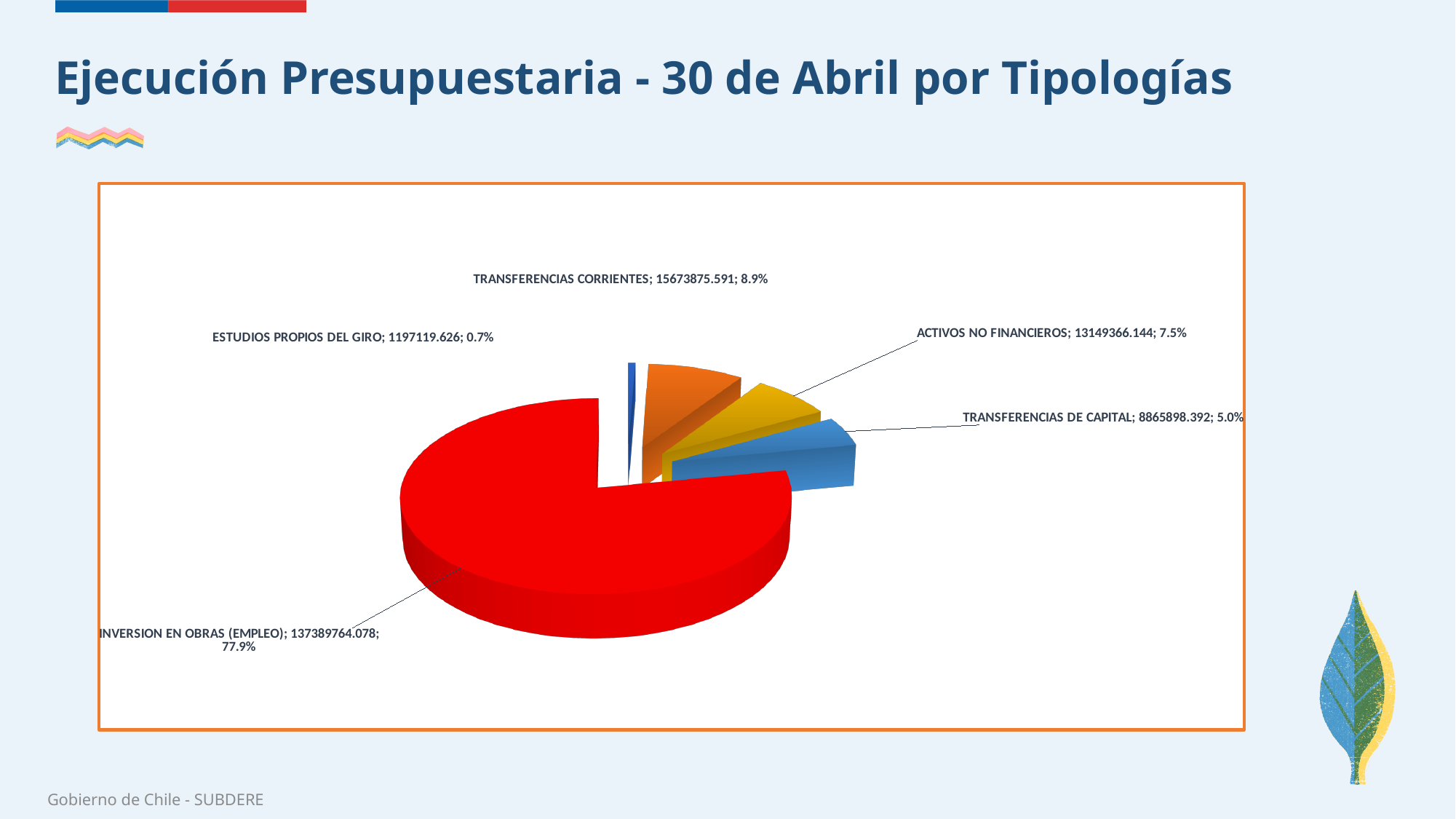
What is the value shown for INVERSION EN OBRAS (EMPLEO)? 137389764.078 What kind of chart is shown on the slide? Pie chart What is the value shown for TRANSFERENCIAS CORRIENTES? 15673875.591 How many slices does the pie chart have? 5 Which category has the smallest slice of the pie? ESTUDIOS PROPIOS DEL GIRO Which is larger, the value for TRANSFERENCIAS CORRIENTES or the value for ACTIVOS NO FINANCIEROS? TRANSFERENCIAS CORRIENTES Which category has the largest slice of the pie? INVERSION EN OBRAS (EMPLEO) What share of the pie does INVERSION EN OBRAS (EMPLEO) represent? 77.9% What is the value shown for ESTUDIOS PROPIOS DEL GIRO? 1197119.626 What is the value shown for ACTIVOS NO FINANCIEROS? 13149366.144 What share of the pie does TRANSFERENCIAS DE CAPITAL represent? 5.0% What is the difference between the values for TRANSFERENCIAS CORRIENTES and ACTIVOS NO FINANCIEROS? 2524509.447